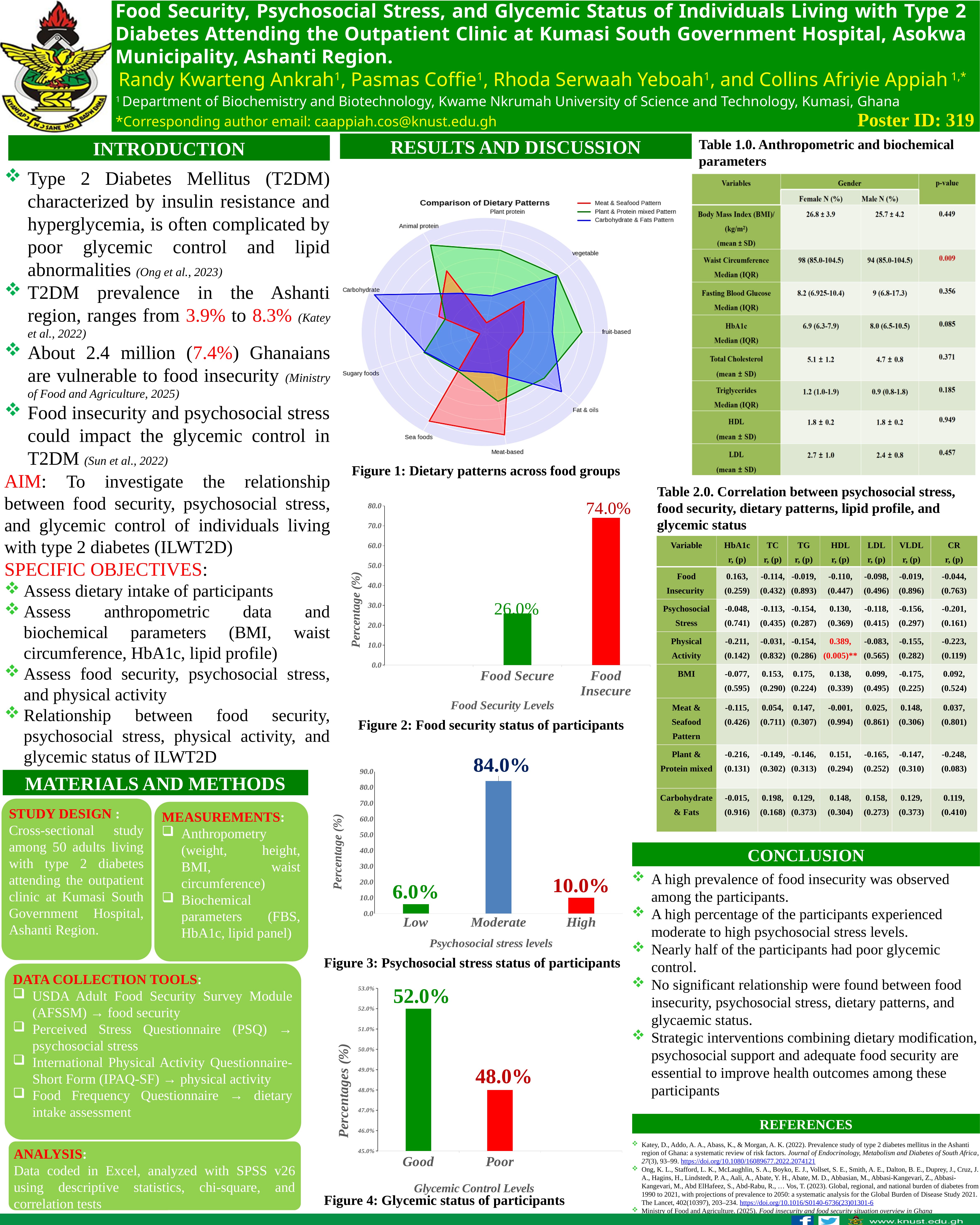
In Figure 2 (Food security status of participants), what percentage of participants are Food Insecure? 74.0% In Figure 1 (Comparison of Dietary Patterns), how many dietary patterns does the legend list? 3 In Figure 4 (Glycemic status of participants), which is larger, the Good or the Poor glycemic control percentage? Good In Figure 3 (Psychosocial stress status of participants), how many stress level categories are shown on the x axis? 3 In Figure 2 (Food security status of participants), what percentage of participants are Food Secure? 26.0% What kind of chart is Figure 2 (Food security status of participants)? Bar chart In Figure 4 (Glycemic status of participants), what percentage of participants have Good glycemic control? 52.0% In Figure 4 (Glycemic status of participants), what is the difference between the Good and Poor percentages? 4.0% In Figure 2 (Food security status of participants), what is the difference between the Food Insecure and Food Secure percentages? 48.0% In Figure 3 (Psychosocial stress status of participants), which stress level has the highest percentage? Moderate In Figure 3 (Psychosocial stress status of participants), which stress level has the lowest percentage? Low In Figure 3 (Psychosocial stress status of participants), what is the percentage for the High stress level? 10.0%